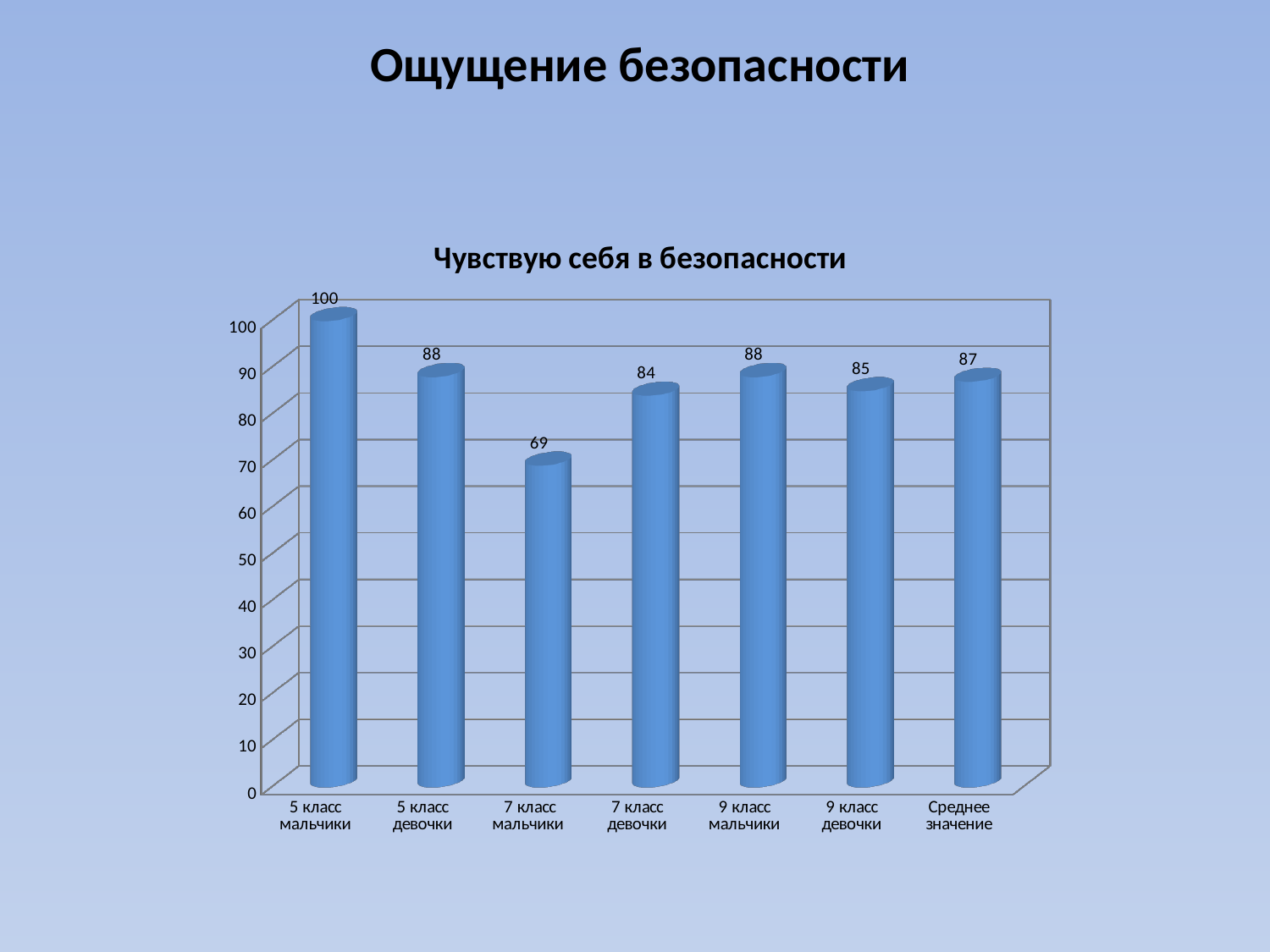
What is the difference between the values for 5 класс мальчики and 7 класс мальчики? 31 What is the value for 5 класс мальчики? 100 Which category has the lowest value? 7 класс мальчики Which is larger, the value for 5 класс девочки or the value for 9 класс девочки? 5 класс девочки What is the value for 7 класс мальчики? 69 What is the title of the chart? Чувствую себя в безопасности What is the difference between the values for 9 класс мальчики and 7 класс девочки? 4 What is the value for 9 класс девочки? 85 What is the value for Среднее значение? 87 How many categories are shown on the x axis? 7 Which category has the highest value? 5 класс мальчики What kind of chart is shown on the slide? bar chart